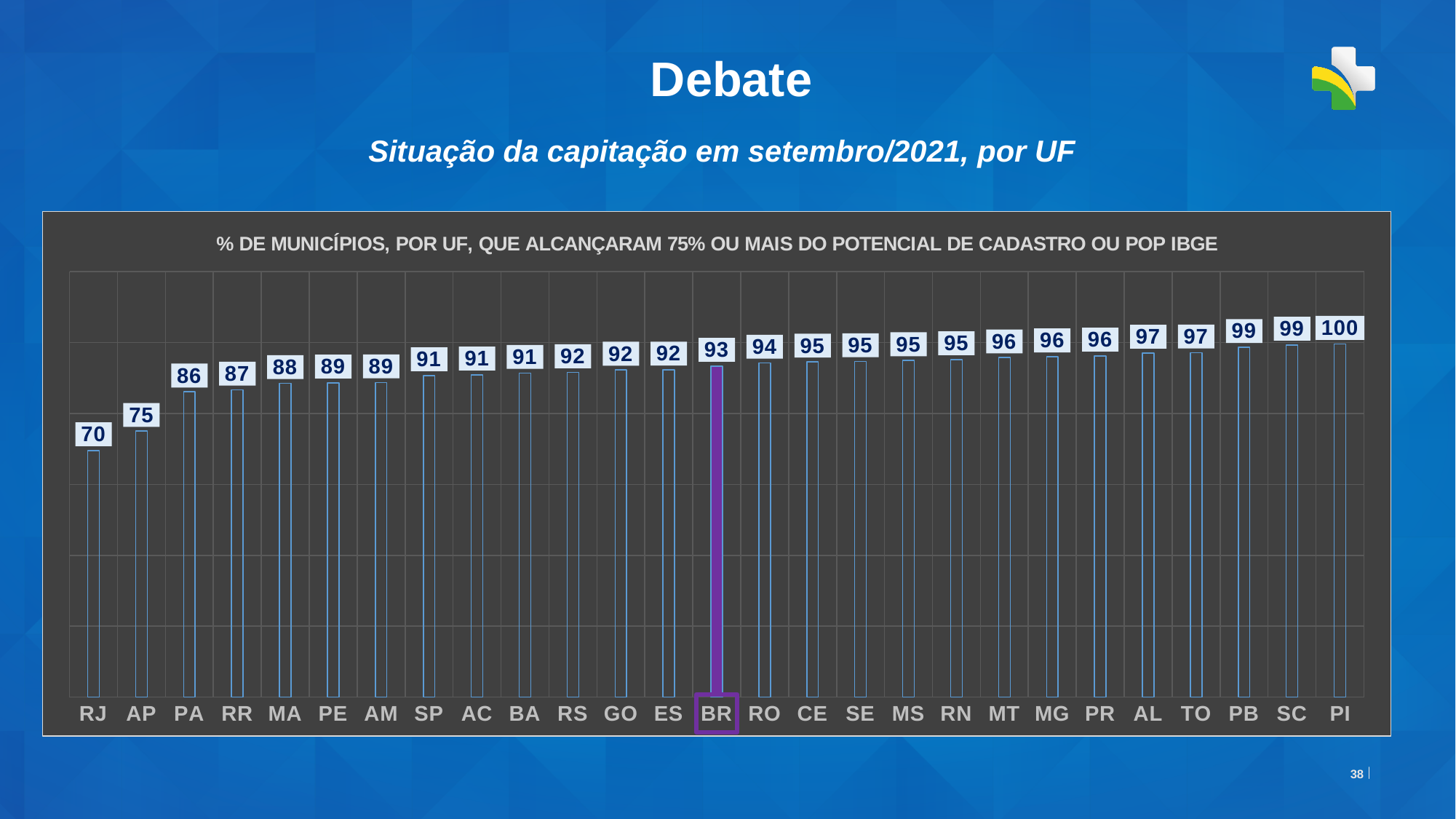
Which UF has the highest value? PI Which UF has the lowest value? RJ Which category's bar is highlighted in purple? BR Do the values rise or fall from left to right along the x axis? rise How many UF categories are shown on the x axis? 27 What is the value for MA? 88 What is the difference between the values for PI and RJ? 30 What is the difference between the values for BR and AP? 18 Which is larger, the value for PA or the value for MT? MT What is the value for RJ? 70 What is the value for BR? 93 What kind of chart is this? bar chart